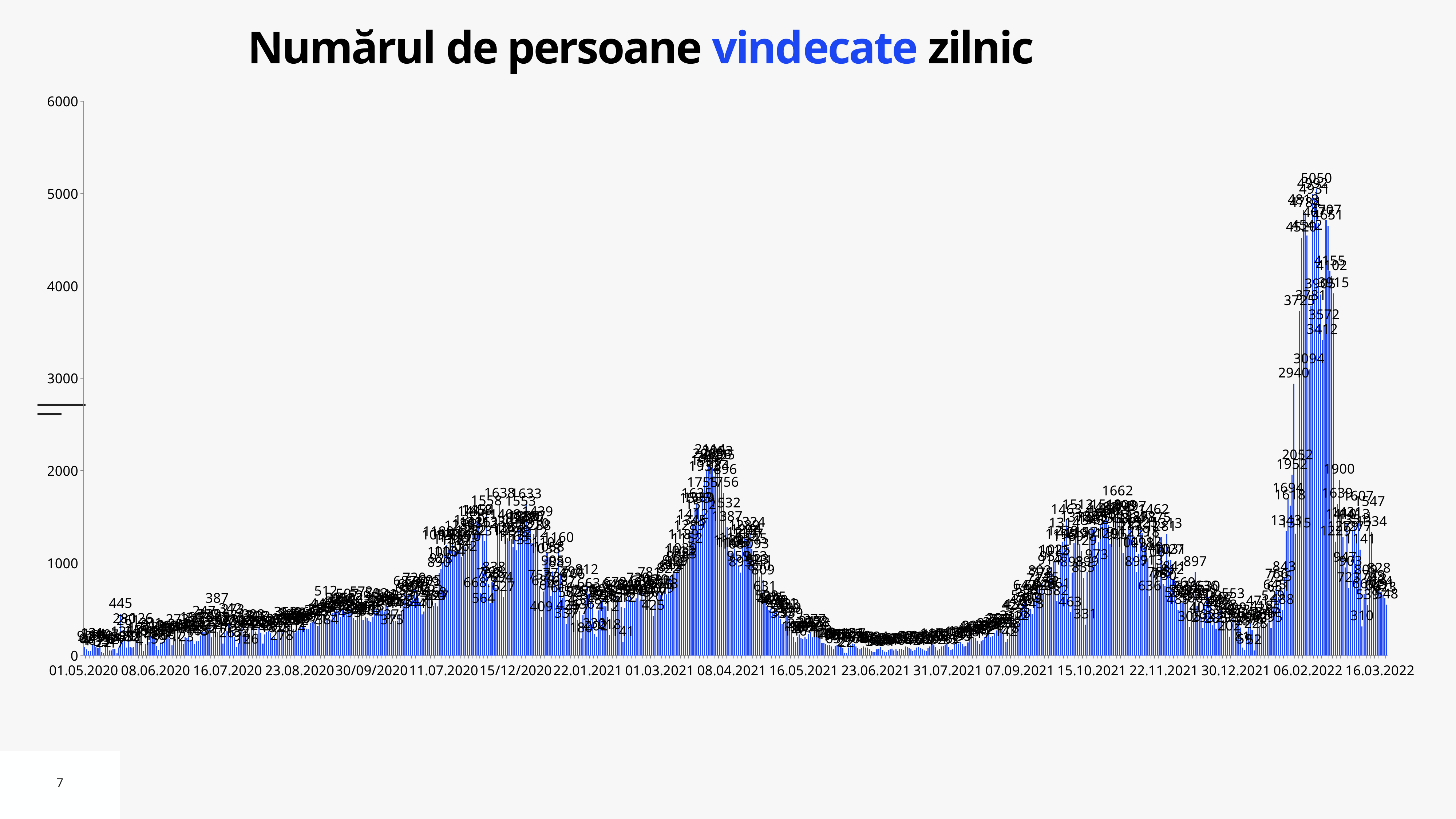
Do the values rise or fall between 07.09.2021 and 15.10.2021? rise Do the values rise or fall between 16.05.2021 and 23.06.2021? fall What is the last date label on the horizontal axis? 16.03.2022 What is the first date label on the horizontal axis? 01.05.2020 Which peak is higher: the one near 08.04.2021 or the one near 06.02.2022? the one near 06.02.2022 What is the highest value labelled in the peak around 15.10.2021? 1662 What is the title of the chart? Numărul de persoane vindecate zilnic What is the highest value shown on the vertical axis? 6000 What kind of chart is shown on the slide? bar chart What is the highest value labelled on the chart? 5050 Is the tallest bar, near 06.02.2022, greater or less than 4000? greater Are the bars around 23.06.2021 greater or less than 500? less